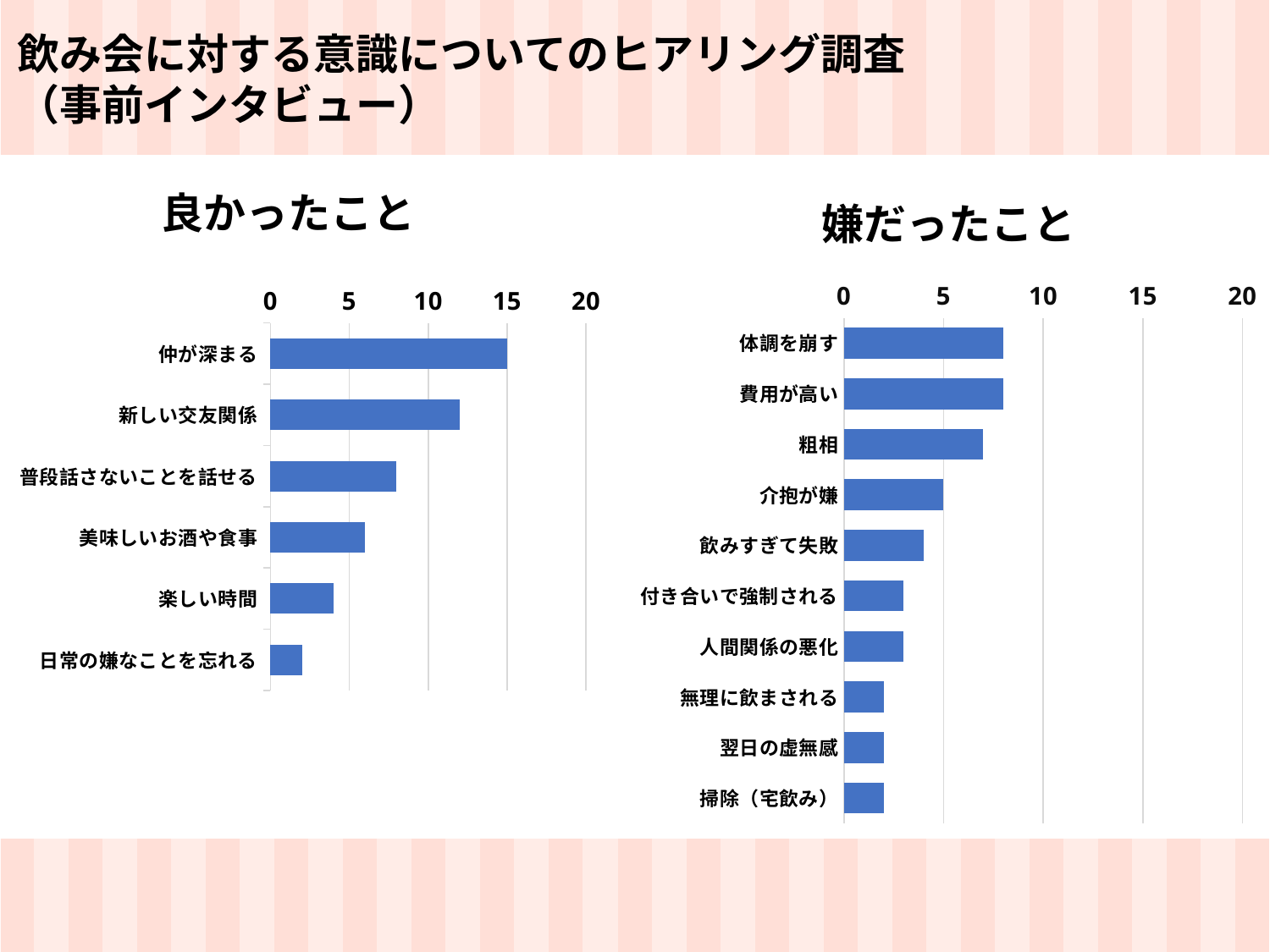
How many categories are shown in the 良かったこと chart? 6 How many categories are shown in the 嫌だったこと chart? 10 In the 良かったこと chart, what is the value for 仲が深まる? 15 In the 良かったこと chart, which category has the highest value? 仲が深まる In the 嫌だったこと chart, what is the value for 介抱が嫌? 5 What kind of chart is the 良かったこと chart on the left? bar chart In the 嫌だったこと chart, is the value for 体調を崩す greater or less than 10? less In the 良かったこと chart, which category has the lowest value? 日常の嫌なことを忘れる In the 良かったこと chart, which is larger: 新しい交友関係 or 普段話さないことを話せる? 新しい交友関係 What is the title of the chart on the right side of the slide? 嫌だったこと In the 嫌だったこと chart, which is larger: 粗相 or 介抱が嫌? 粗相 In the 良かったこと chart, is the value for 新しい交友関係 greater or less than 10? greater